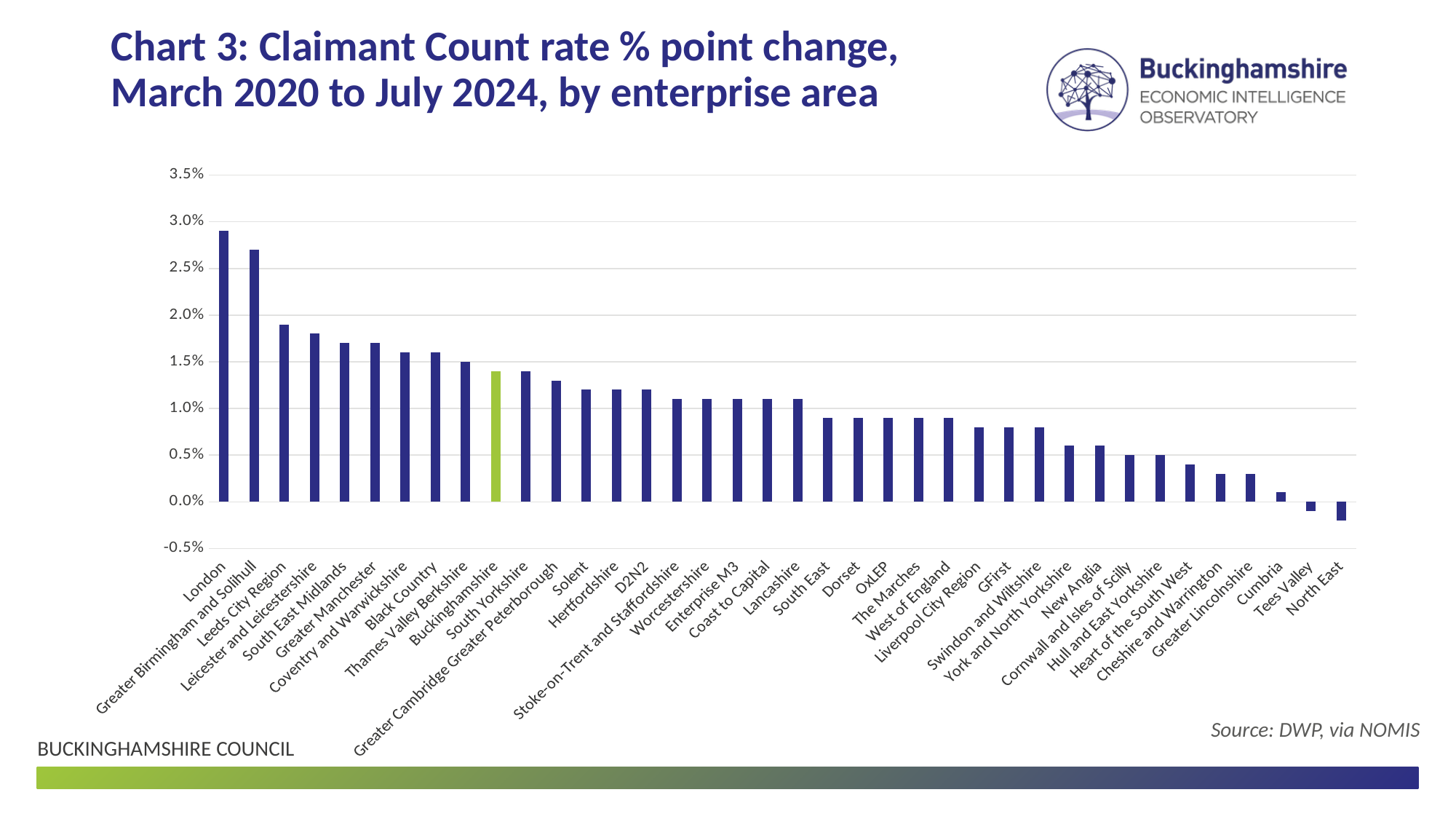
How many enterprise areas are shown on the chart? 38 Is the value for North East greater or less than 0.0%? less Which enterprise area has the highest claimant count rate % point change? London Which has the larger value, London or Greater Birmingham and Solihull? London Is the value for Cumbria greater or less than 0.5%? less What kind of chart is shown on the slide? Bar chart Is the value for Buckinghamshire greater or less than 1.0%? greater Do the values rise or fall moving from left to right along the x axis? Fall Which has the larger value, Buckinghamshire or South East? Buckinghamshire Which enterprise area's bar is highlighted in green? Buckinghamshire Which enterprise area has the lowest claimant count rate % point change? North East